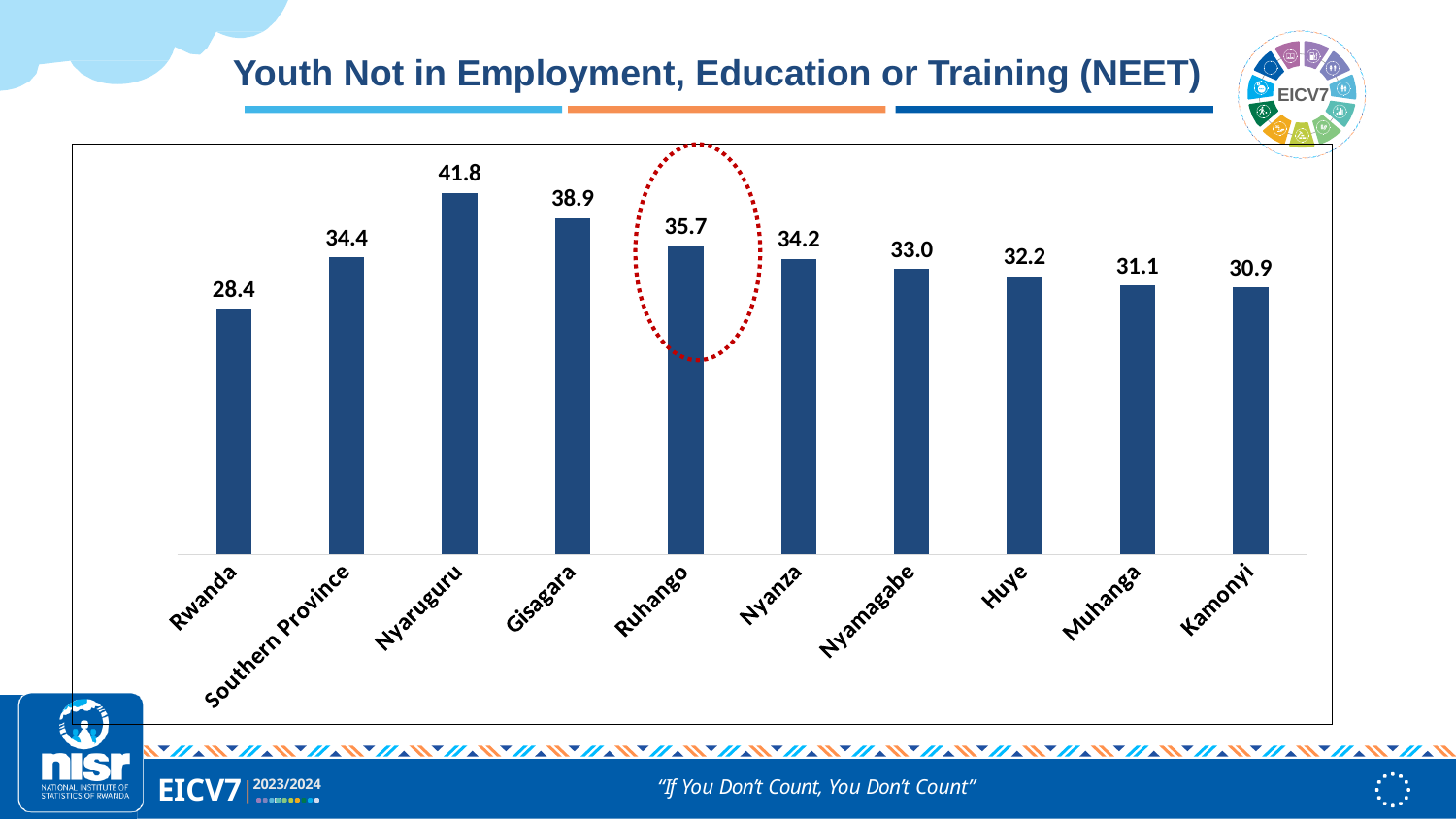
Which is larger, the value for Nyanza or the value for Nyamagabe? Nyanza Which category has the lowest value? Rwanda Which category has the highest value? Nyaruguru What is the difference between the values for Nyaruguru and Rwanda? 13.4 What kind of chart is shown on the slide? Bar chart What is the difference between the values for Gisagara and Kamonyi? 8.0 What is the value for Ruhango? 35.7 What is the title of the chart? Youth Not in Employment, Education or Training (NEET) How many categories are shown on the x axis? 10 What is the value for Southern Province? 34.4 Which is larger, the value for Huye or the value for Muhanga? Huye What is the value for Rwanda? 28.4